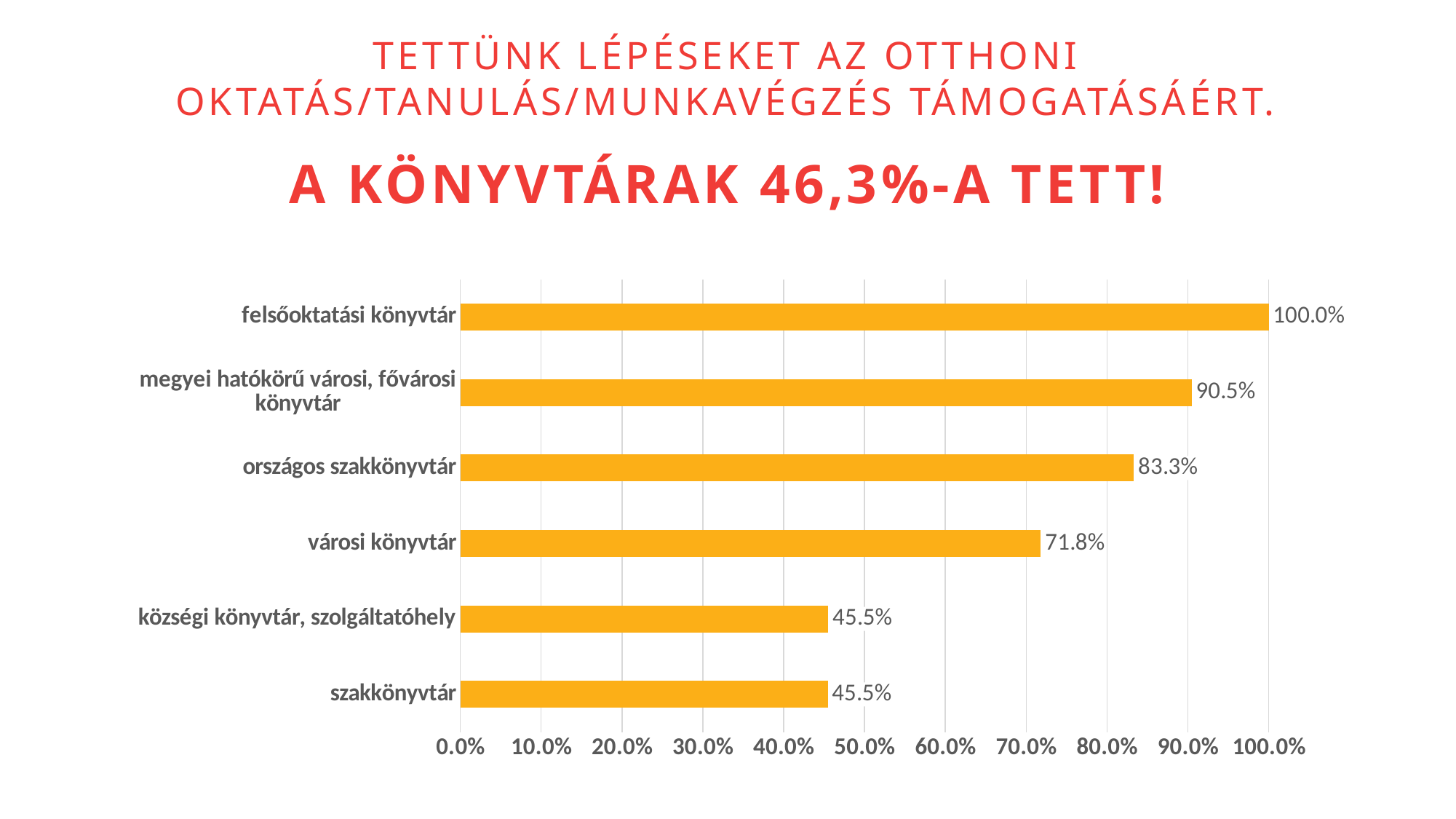
What is the value for városi könyvtár? 71.8% What kind of chart is shown on the slide? bar chart What is the value for megyei hatókörű városi, fővárosi könyvtár? 90.5% What is the value for községi könyvtár, szolgáltatóhely? 45.5% How many categories are shown in the chart? 6 What is the value for országos szakkönyvtár? 83.3% What is the difference between the values for megyei hatókörű városi, fővárosi könyvtár and országos szakkönyvtár? 7.2% What colour are the bars in the chart? orange What is the value for felsőoktatási könyvtár? 100.0% What is the difference between the values for felsőoktatási könyvtár and városi könyvtár? 28.2% Which is larger, the value for országos szakkönyvtár or the value for városi könyvtár? országos szakkönyvtár Which category has the highest value? felsőoktatási könyvtár